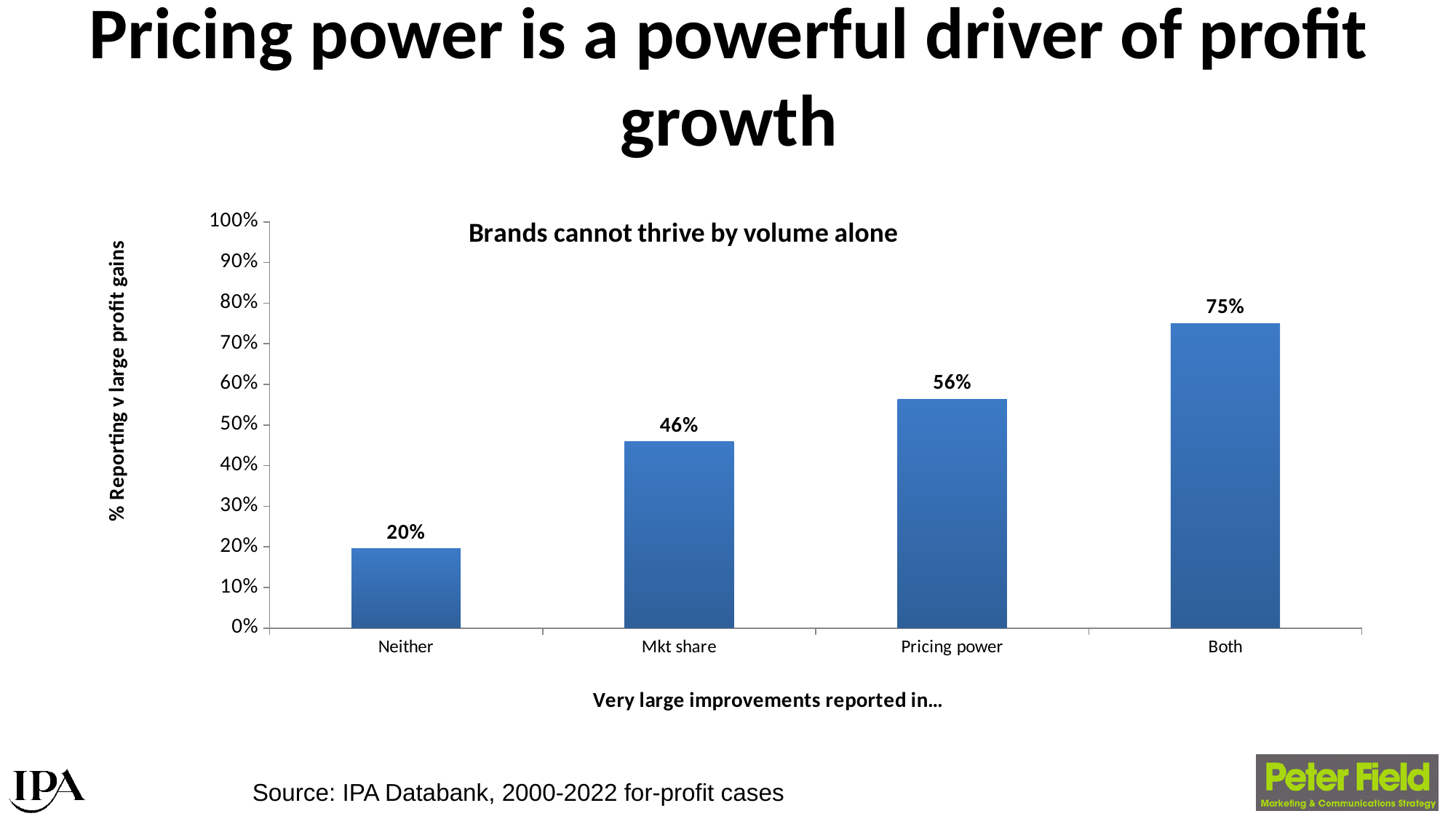
Which is larger, the value for Pricing power or the value for Mkt share? Pricing power How many categories are shown on the x axis? 4 Which category has the lowest value? Neither What is the value for Neither? 20% What is the value for Mkt share? 46% What is the difference between the values for Pricing power and Mkt share? 10% What kind of chart is this? bar chart What is the difference between the values for Both and Neither? 55% What is the value for Pricing power? 56% What is the title of the chart? Brands cannot thrive by volume alone Is the value for Both greater or less than 70%? greater Which category has the highest value? Both